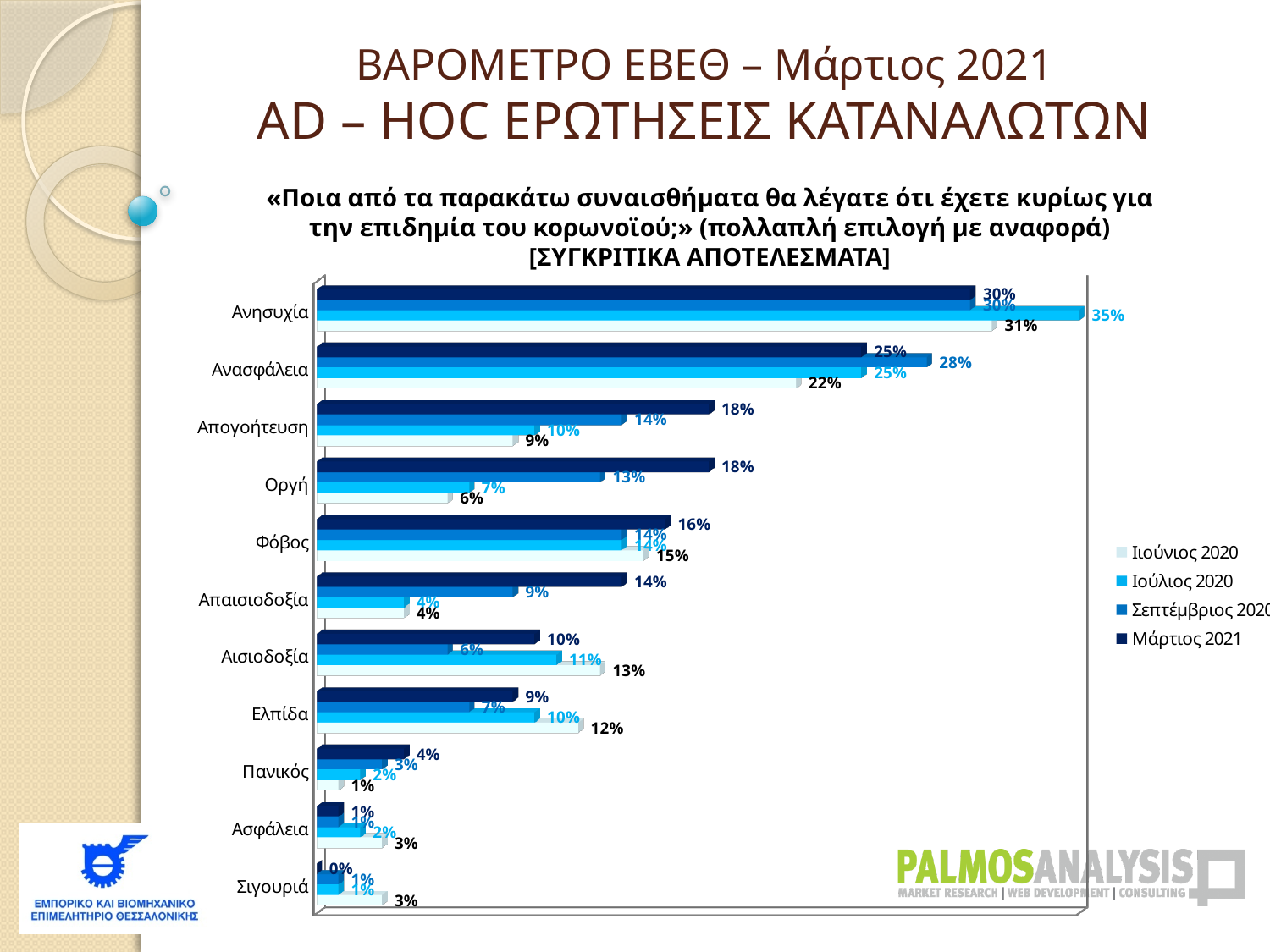
Which series is shown in the darkest blue colour in the legend? Μάρτιος 2021 How many series does the legend list? 4 For Ελπίδα, which is larger: the Ιούνιος 2020 value or the Μάρτιος 2021 value? Ιούνιος 2020 Which category has the lowest Μάρτιος 2021 value? Σιγουριά What is the Μάρτιος 2021 value for Απογοήτευση? 18% How many categories (feelings) are shown on the chart? 11 Which category has the highest Μάρτιος 2021 value? Ανησυχία What is the difference between the Μάρτιος 2021 and Ιούνιος 2020 values for Οργή? 12 percentage points What kind of chart is shown on the slide? Bar chart What is the Ιούνιος 2020 value for Αισιοδοξία? 13% What is the Ιούλιος 2020 value for Ανησυχία? 35% What is the Σεπτέμβριος 2020 value for Ανασφάλεια? 28%